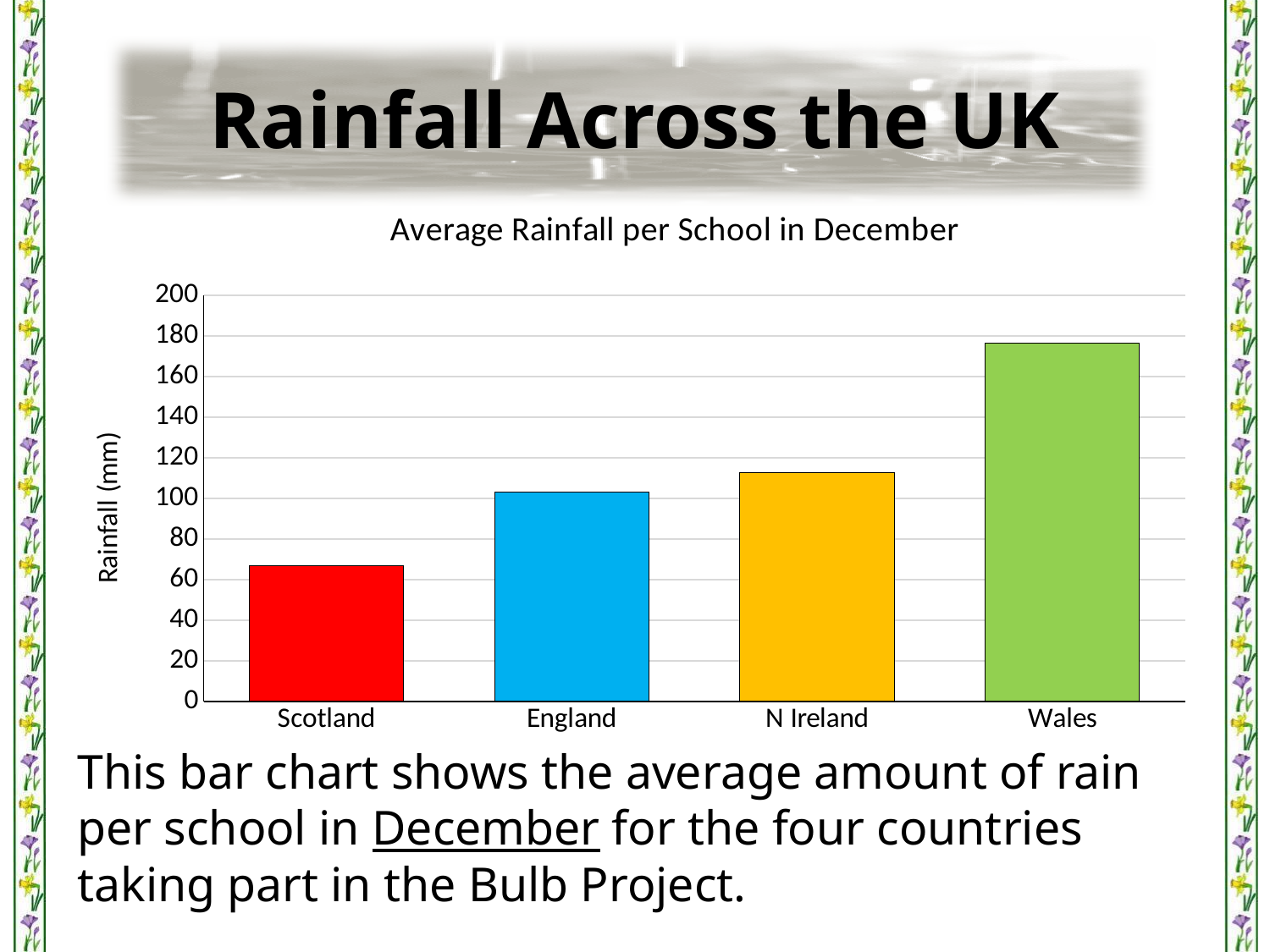
Which country has the highest average rainfall on the chart? Wales Is the value for Wales greater or less than 160? greater Is the value for N Ireland greater or less than 120? less Which has the higher average rainfall, England or N Ireland? N Ireland What kind of chart is shown on the slide? Bar chart What is the title of the chart? Average Rainfall per School in December What is the label on the vertical axis of the chart? Rainfall (mm) Do the values rise or fall moving from Scotland to Wales along the x axis? rise Which country has the lowest average rainfall on the chart? Scotland How many countries are shown on the chart? 4 Is the value for Scotland greater or less than 60? greater